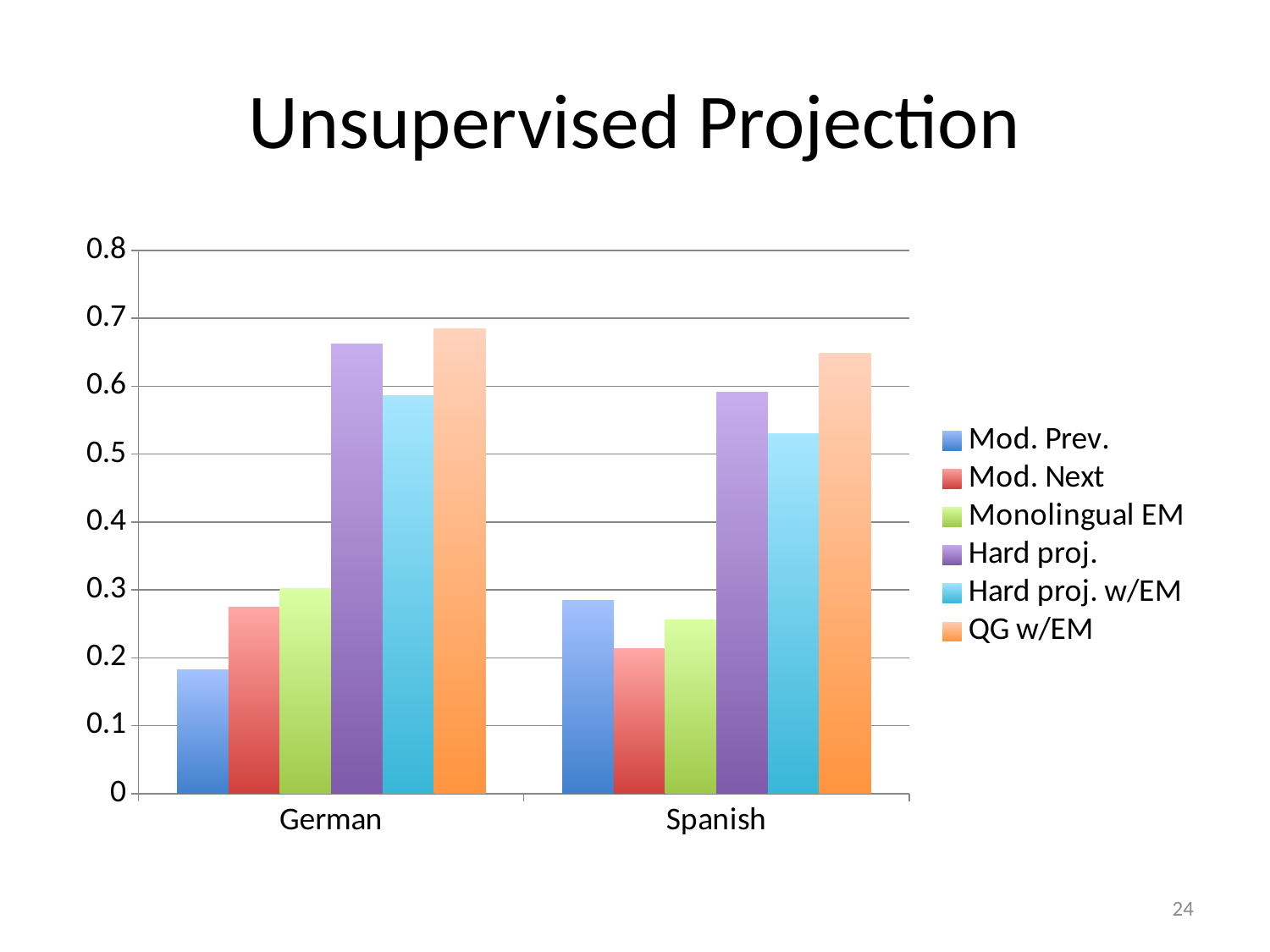
Which series has the highest value for German? QG w/EM Which series has the highest value for Spanish? QG w/EM Which series has the lowest value for German? Mod. Prev. Which series has the lowest value for Spanish? Mod. Next How many language categories are shown on the x axis? 2 Is the value for Hard proj. for German greater or less than 0.6? greater What is the title of the chart? Unsupervised Projection Is the value for Monolingual EM for Spanish greater or less than 0.3? less Is the value for Hard proj. w/EM for Spanish greater or less than 0.5? greater What kind of chart is shown on the slide? bar chart For German, which is larger: Hard proj. or Hard proj. w/EM? Hard proj. How many series does the legend list? 6